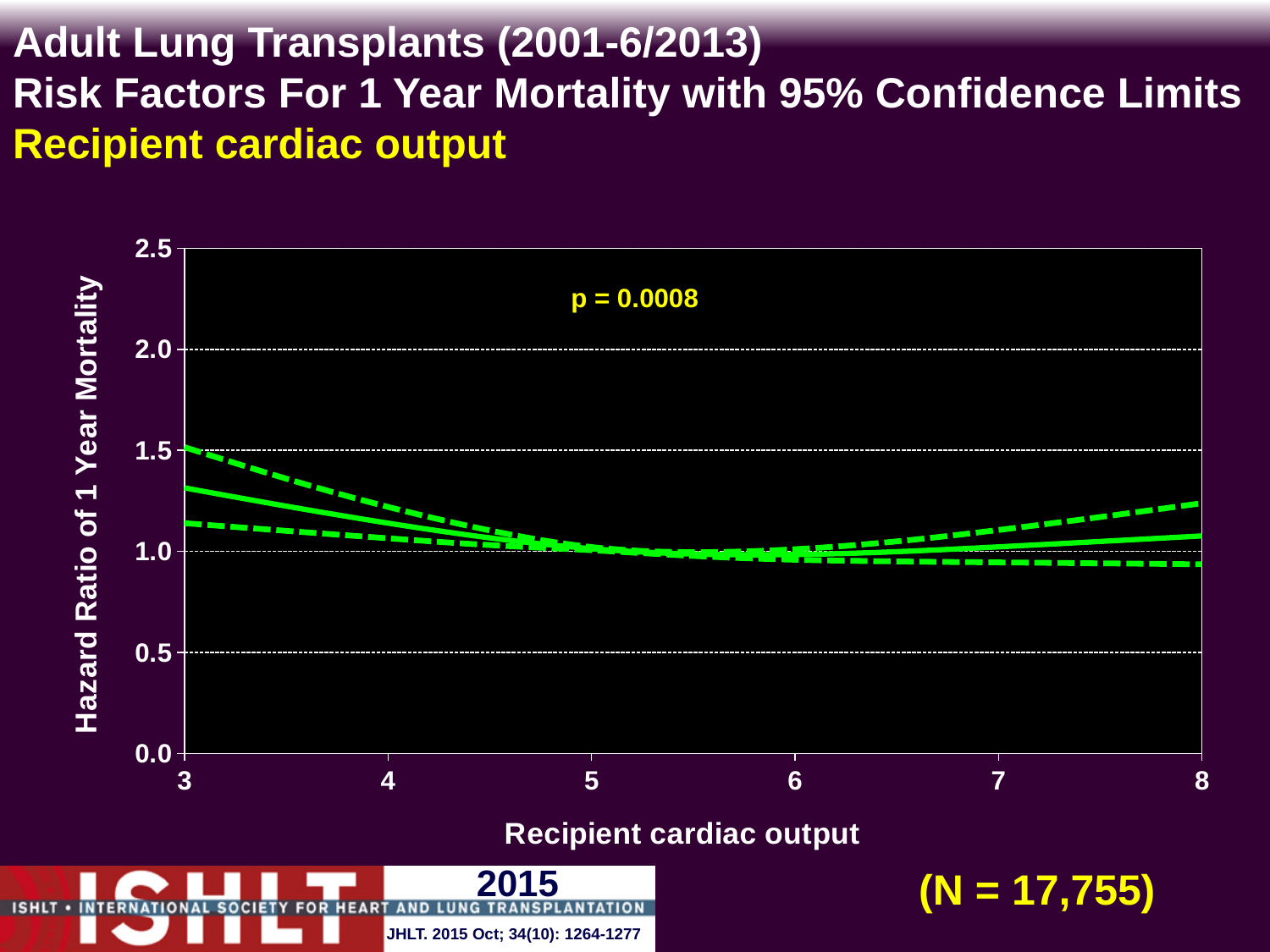
What is the highest value shown on the y axis? 2.5 How many lines are plotted on the chart? 3 Is the upper dashed confidence limit at a recipient cardiac output of 8 greater or less than 1.5? less Is the upper dashed confidence limit at a recipient cardiac output of 8 greater or less than 1.0? greater Is the hazard ratio of the solid line at a recipient cardiac output of 3 greater or less than 1.0? greater What is the label of the y axis? Hazard Ratio of 1 Year Mortality What is the label of the x axis? Recipient cardiac output What sample size (N) is printed on the slide? N = 17,755 What kind of chart is shown on the slide? line chart Does the solid hazard ratio line rise or fall as recipient cardiac output increases from 3 to 5? fall What p-value is printed on the chart? p = 0.0008